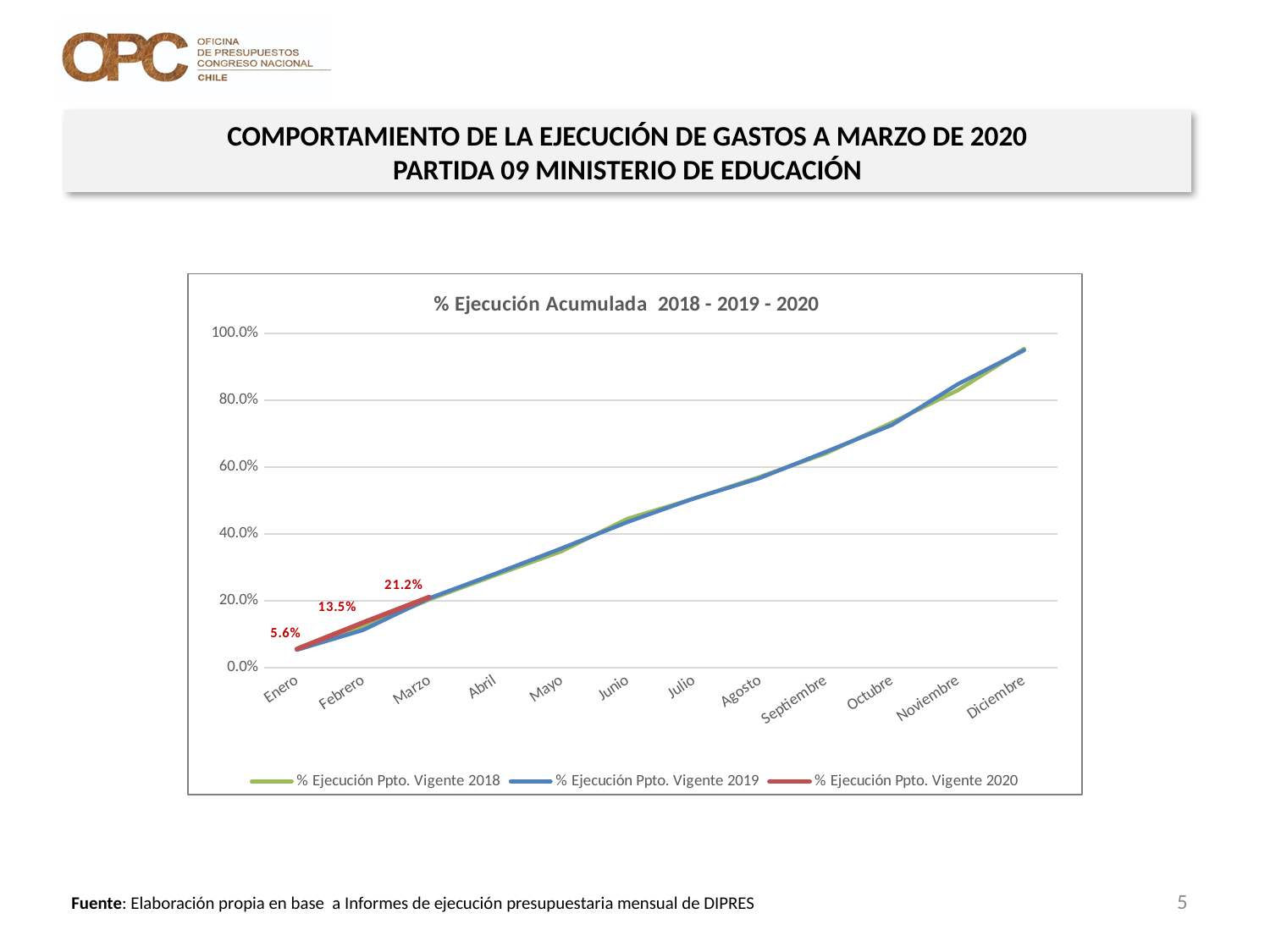
What is the difference between the 2020 values for Marzo and Enero? 15.6% What is the value of % Ejecución Ppto. Vigente 2020 for Marzo? 21.2% How many months are shown on the x axis of the chart? 12 Do the values of % Ejecución Ppto. Vigente 2019 rise or fall from Enero to Diciembre? rise What is the difference between the 2020 values for Febrero and Enero? 7.9% Is the value of % Ejecución Ppto. Vigente 2019 for Junio greater or less than 60%? less What kind of chart is shown on the slide? line chart Is the value of % Ejecución Ppto. Vigente 2019 for Octubre greater or less than 60%? greater What is the value of % Ejecución Ppto. Vigente 2020 for Enero? 5.6% Is the value of % Ejecución Ppto. Vigente 2019 for Diciembre greater or less than 80%? greater What is the value of % Ejecución Ppto. Vigente 2020 for Febrero? 13.5% How many series does the legend list? 3